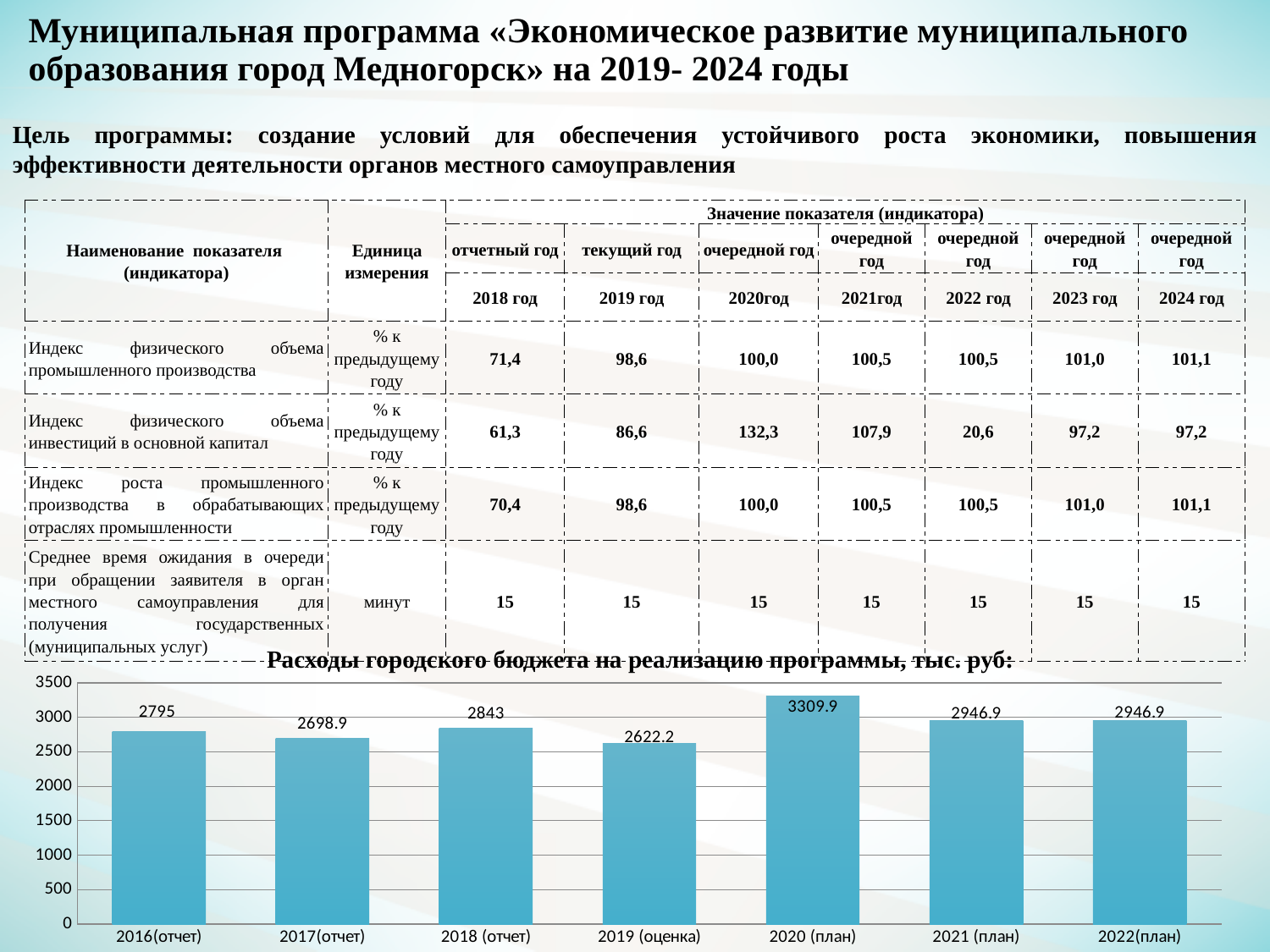
What is the value for 2016(отчет) in the chart «Расходы городского бюджета на реализацию программы, тыс. руб»? 2795 What is the title of the chart at the bottom of the slide? Расходы городского бюджета на реализацию программы, тыс. руб: What is the value for 2020 (план) in the chart «Расходы городского бюджета на реализацию программы, тыс. руб»? 3309.9 Which category has the highest value in the chart «Расходы городского бюджета на реализацию программы, тыс. руб»? 2020 (план) What is the difference between the values for 2018 (отчет) and 2017(отчет) in the chart «Расходы городского бюджета на реализацию программы, тыс. руб»? 144.1 What is the value for 2019 (оценка) in the chart «Расходы городского бюджета на реализацию программы, тыс. руб»? 2622.2 Which is larger in the chart «Расходы городского бюджета на реализацию программы, тыс. руб»: the value for 2016(отчет) or for 2017(отчет)? 2016(отчет) How many categories are shown in the chart «Расходы городского бюджета на реализацию программы, тыс. руб»? 7 Is the value for 2020 (план) in the chart «Расходы городского бюджета на реализацию программы, тыс. руб» greater or less than 3000? greater Which category has the lowest value in the chart «Расходы городского бюджета на реализацию программы, тыс. руб»? 2019 (оценка) What kind of chart is «Расходы городского бюджета на реализацию программы, тыс. руб»? bar chart What is the difference between the values for 2020 (план) and 2019 (оценка) in the chart «Расходы городского бюджета на реализацию программы, тыс. руб»? 687.7